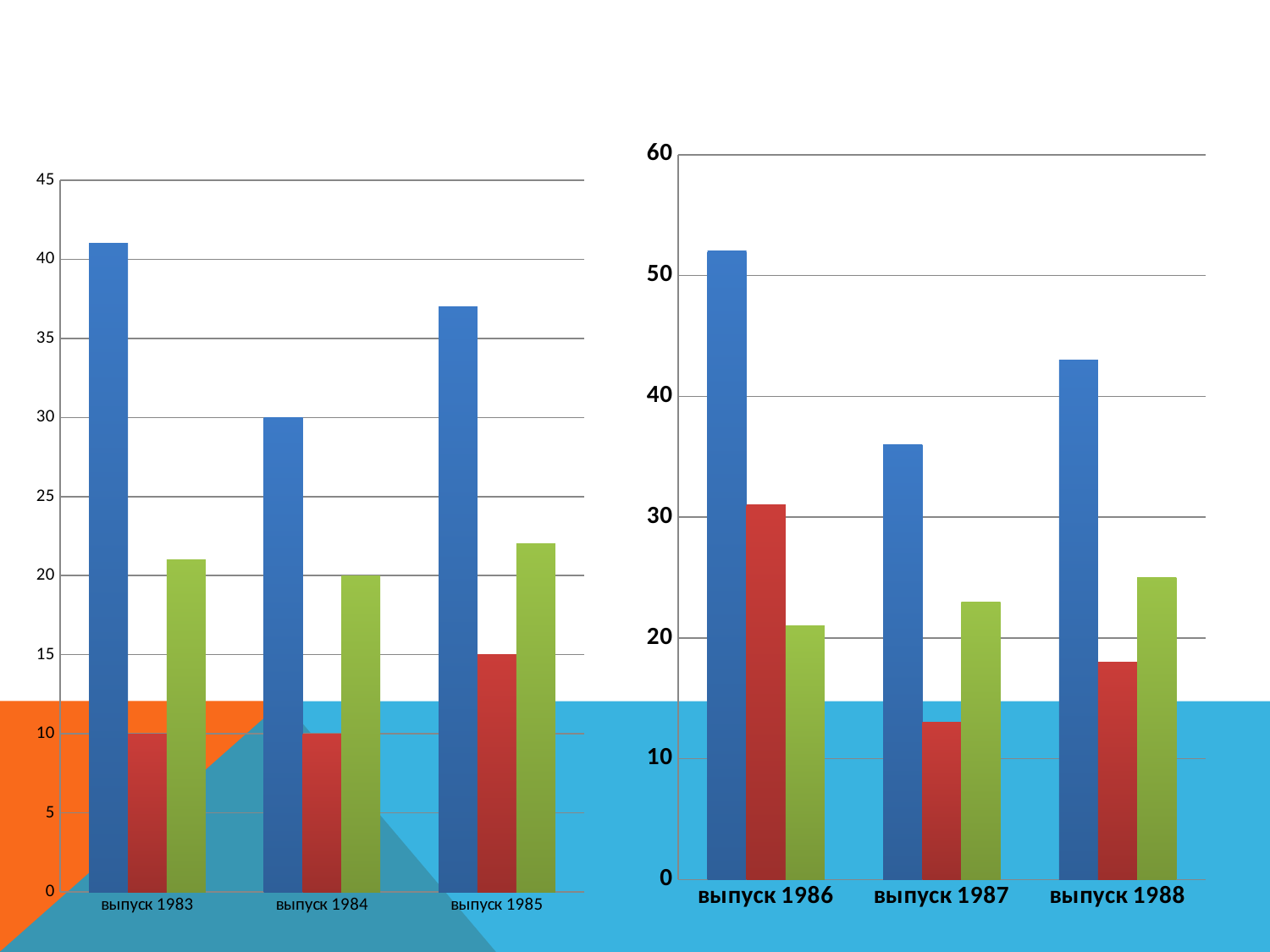
In the right-hand chart, which is larger for выпуск 1988: the red bar or the green bar? the green bar In the left-hand chart, is the green bar for выпуск 1985 greater or less than 20? greater In the right-hand chart, which is larger for выпуск 1986: the red bar or the green bar? the red bar In the left-hand chart, is the blue bar for выпуск 1983 greater or less than 40? greater How many categories are shown on the x axis of the right-hand chart? 3 In the right-hand chart, which category has the tallest red bar? выпуск 1986 In the left-hand chart, which category has the tallest blue bar? выпуск 1983 What is the highest value shown on the vertical axis of the right-hand chart? 60 In the right-hand chart, is the blue bar for выпуск 1986 greater or less than 50? greater What kind of chart is the chart on the left side of the slide? bar chart In the right-hand chart, which category has the shortest blue bar? выпуск 1987